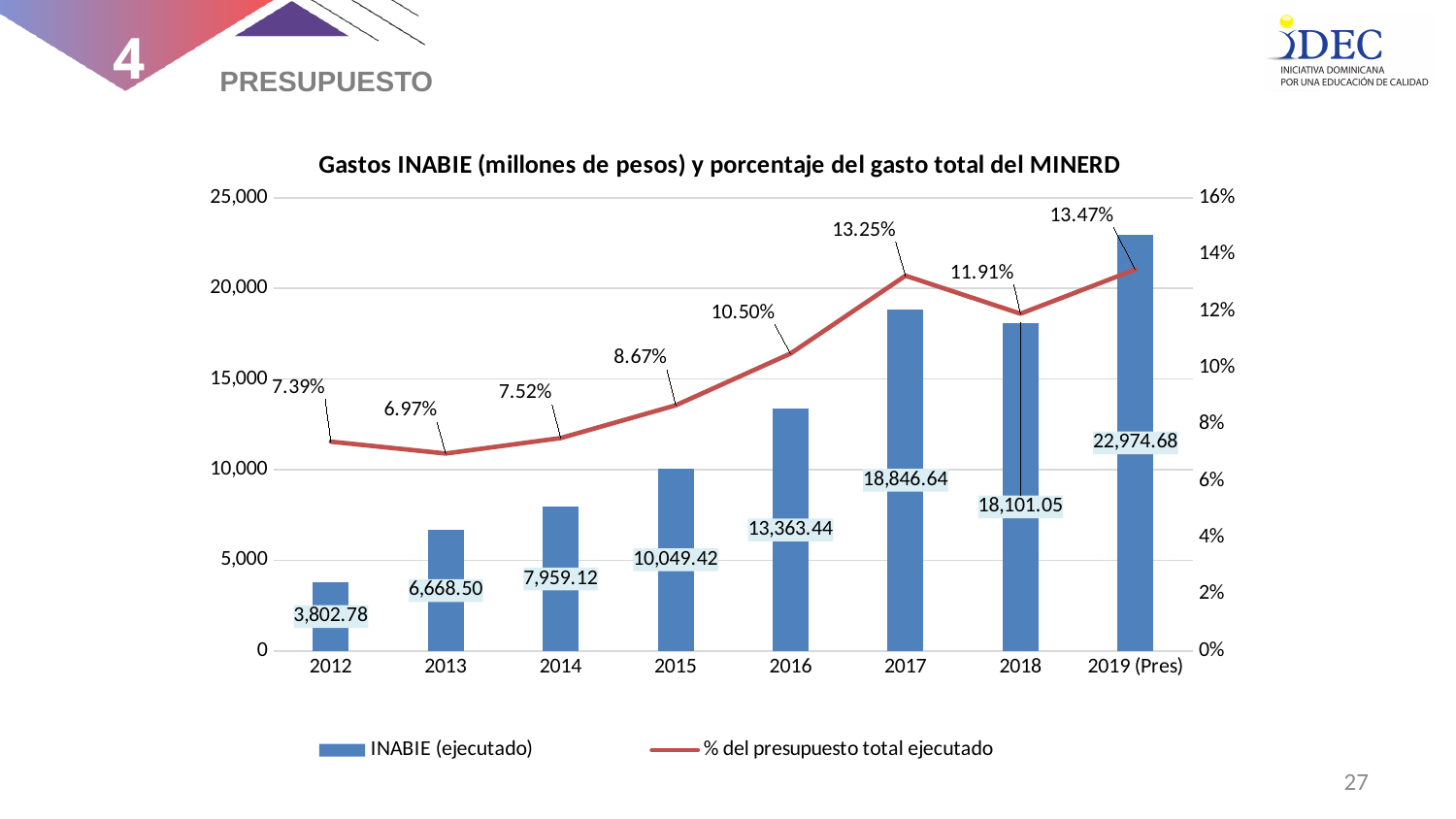
Which year has the lowest value for % del presupuesto total ejecutado? 2013 Which year has the highest INABIE (ejecutado) value? 2019 (Pres) What is the INABIE (ejecutado) value for 2012? 3,802.78 By how many percentage points does the % del presupuesto total ejecutado differ between 2017 and 2018? 1.34 What is the title of the chart? Gastos INABIE (millones de pesos) y porcentaje del gasto total del MINERD What kind of chart is this? Combined bar and line chart What is the difference between the INABIE (ejecutado) values for 2019 (Pres) and 2018? 4,873.63 How many series does the legend list? 2 What percentage of the total budget executed is shown for 2017? 13.25% How many years are shown on the x axis? 8 What is the INABIE (ejecutado) value for 2016? 13,363.44 Which is larger, the INABIE (ejecutado) value for 2017 or for 2018? 2017